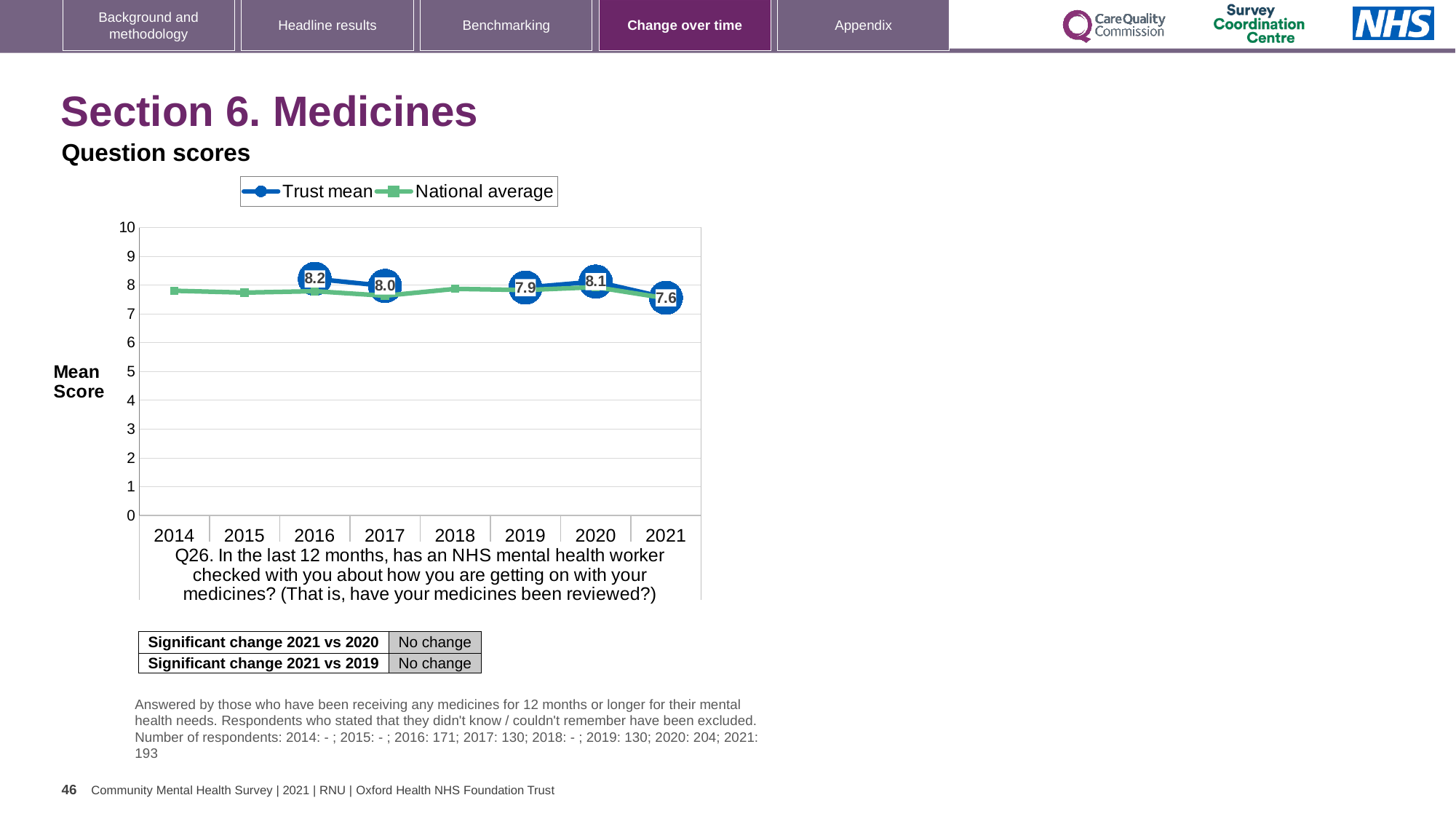
What is the difference between the Trust mean scores for 2020 and 2021? 0.5 In which year is the labelled Trust mean score lowest? 2021 What kind of chart is shown on the slide? line chart In which year is the labelled Trust mean score highest? 2016 What is the Trust mean score for 2017? 8.0 What is the Trust mean score for 2021? 7.6 Which is larger, the Trust mean score for 2019 or for 2020? 2020 Is the National average score for 2018 greater or less than 9? less How many series does the legend list? 2 What is the Trust mean score for 2020? 8.1 What is the Trust mean score for 2016? 8.2 How many years are shown on the x axis? 8